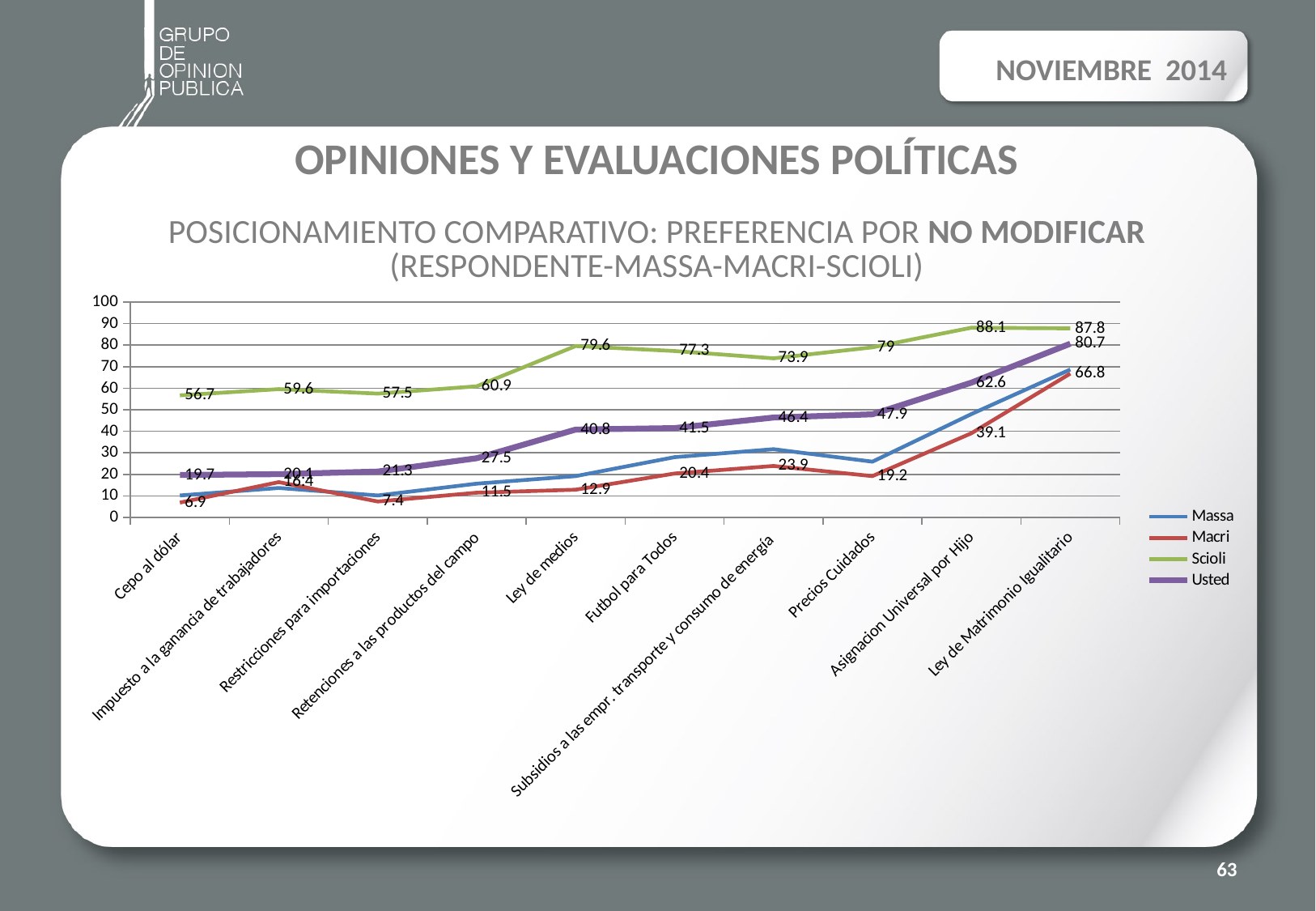
What is the value for Scioli at Ley de medios? 79.6 What is the difference between Scioli and Usted at Ley de Matrimonio Igualitario? 7.1 How many series does the legend list? 4 What kind of chart is shown on the slide? line chart Does the Usted series generally rise or fall from Cepo al dólar to Ley de Matrimonio Igualitario? rise Is the value for Massa at Ley de Matrimonio Igualitario greater or less than 60? greater At Precios Cuidados, which is larger: Usted or Macri? Usted What is the value for Macri at Cepo al dólar? 6.9 What is the value for Usted at Ley de Matrimonio Igualitario? 80.7 For which category is the Macri series lowest? Cepo al dólar How many categories are plotted along the x axis? 10 For which category is the Scioli series highest? Asignacion Universal por Hijo